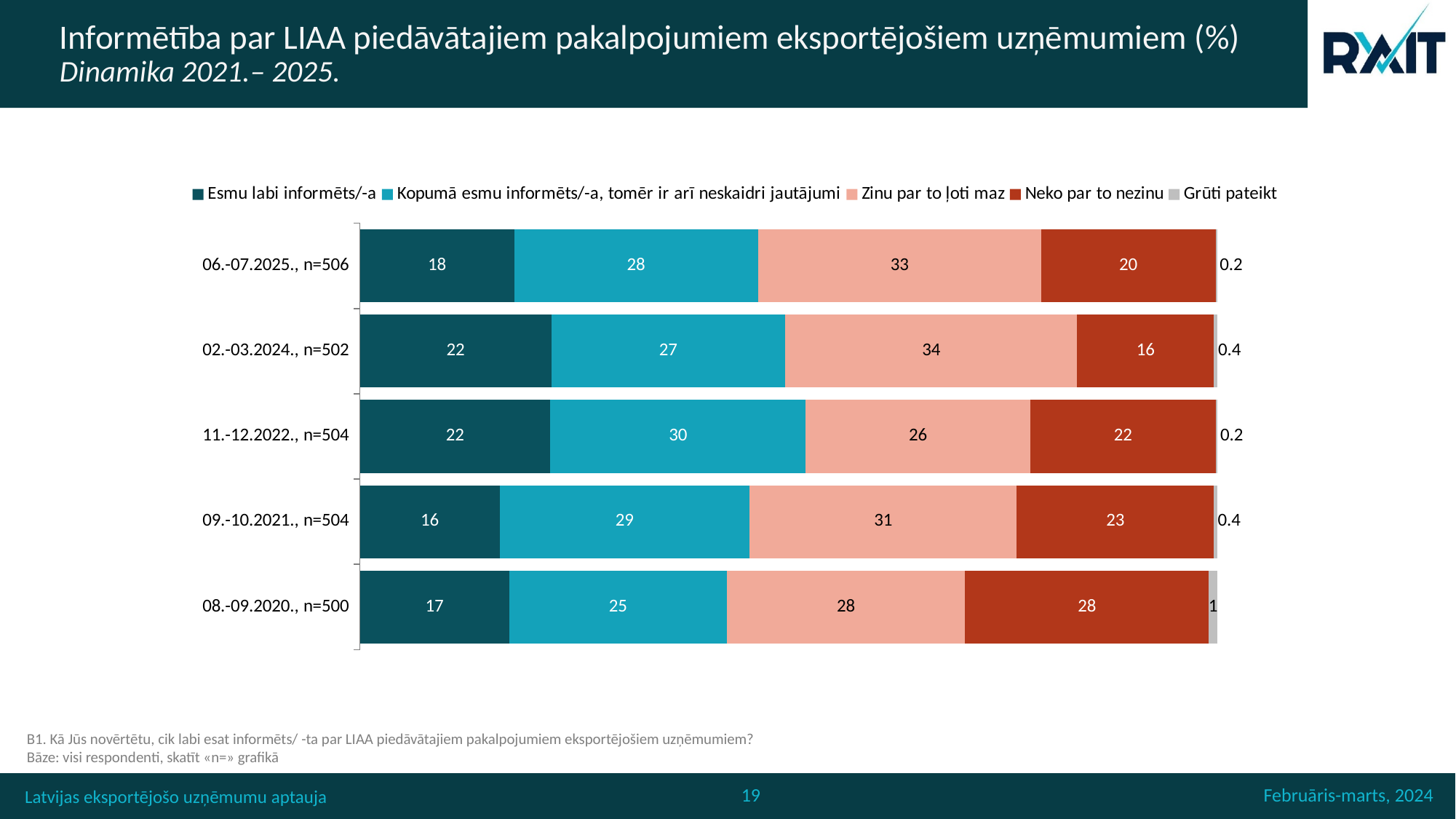
What is the difference between the "Kopumā esmu informēts/-a, tomēr ir arī neskaidri jautājumi" values for 11.-12.2022., n=504 and 08.-09.2020., n=500? 5 What is the value for "Zinu par to ļoti maz" in the 02.-03.2024., n=502 bar? 34 What is the value for "Grūti pateikt" in the 09.-10.2021., n=504 bar? 0.4 What is the total of the 08.-09.2020., n=500 stacked bar? 99 Which survey wave has the highest value for "Neko par to nezinu"? 08.-09.2020., n=500 How many survey waves (bars) are shown in the chart? 5 What is the value for "Esmu labi informēts/-a" in the 06.-07.2025., n=506 bar? 18 How many series does the legend list? 5 Which has the larger "Zinu par to ļoti maz" value: 06.-07.2025., n=506 or 09.-10.2021., n=504? 06.-07.2025., n=506 Which survey wave has the lowest value for "Esmu labi informēts/-a"? 09.-10.2021., n=504 What is the value for "Neko par to nezinu" in the 08.-09.2020., n=500 bar? 28 What kind of chart is shown on the slide? Stacked bar chart